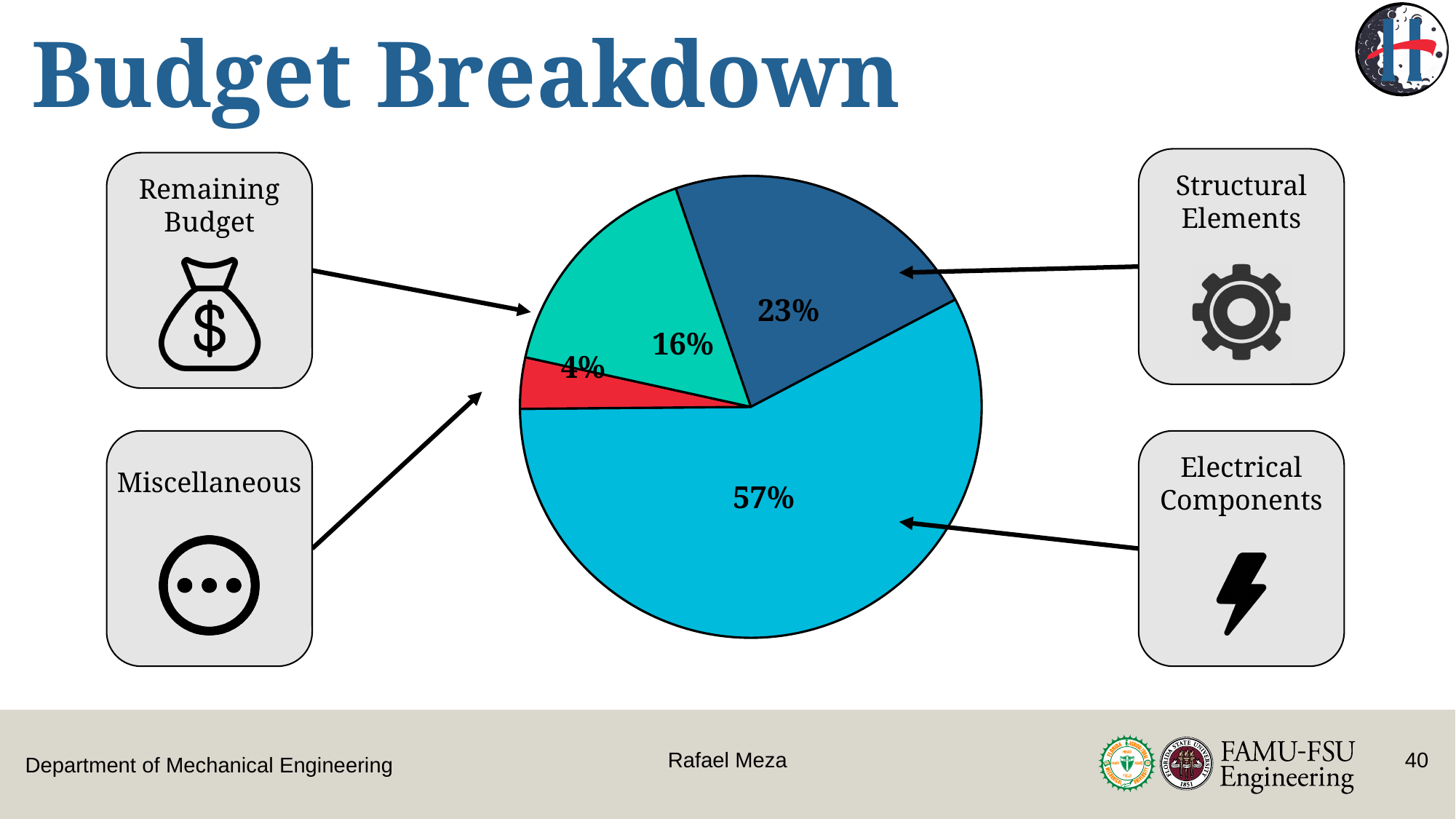
What share of the budget is the Remaining Budget? 16% What kind of chart is shown on the slide? pie chart What share of the budget is Miscellaneous? 4% What is the difference in percentage points between Electrical Components and Structural Elements? 34 What is the title of the slide containing the pie chart? Budget Breakdown Which category has the smallest slice of the pie? Miscellaneous How many slices does the pie chart have? 4 Which category has the largest slice of the pie? Electrical Components Which is larger, the Structural Elements slice or the Remaining Budget slice? Structural Elements What share of the budget goes to Electrical Components? 57% What is the difference in percentage points between Remaining Budget and Miscellaneous? 12